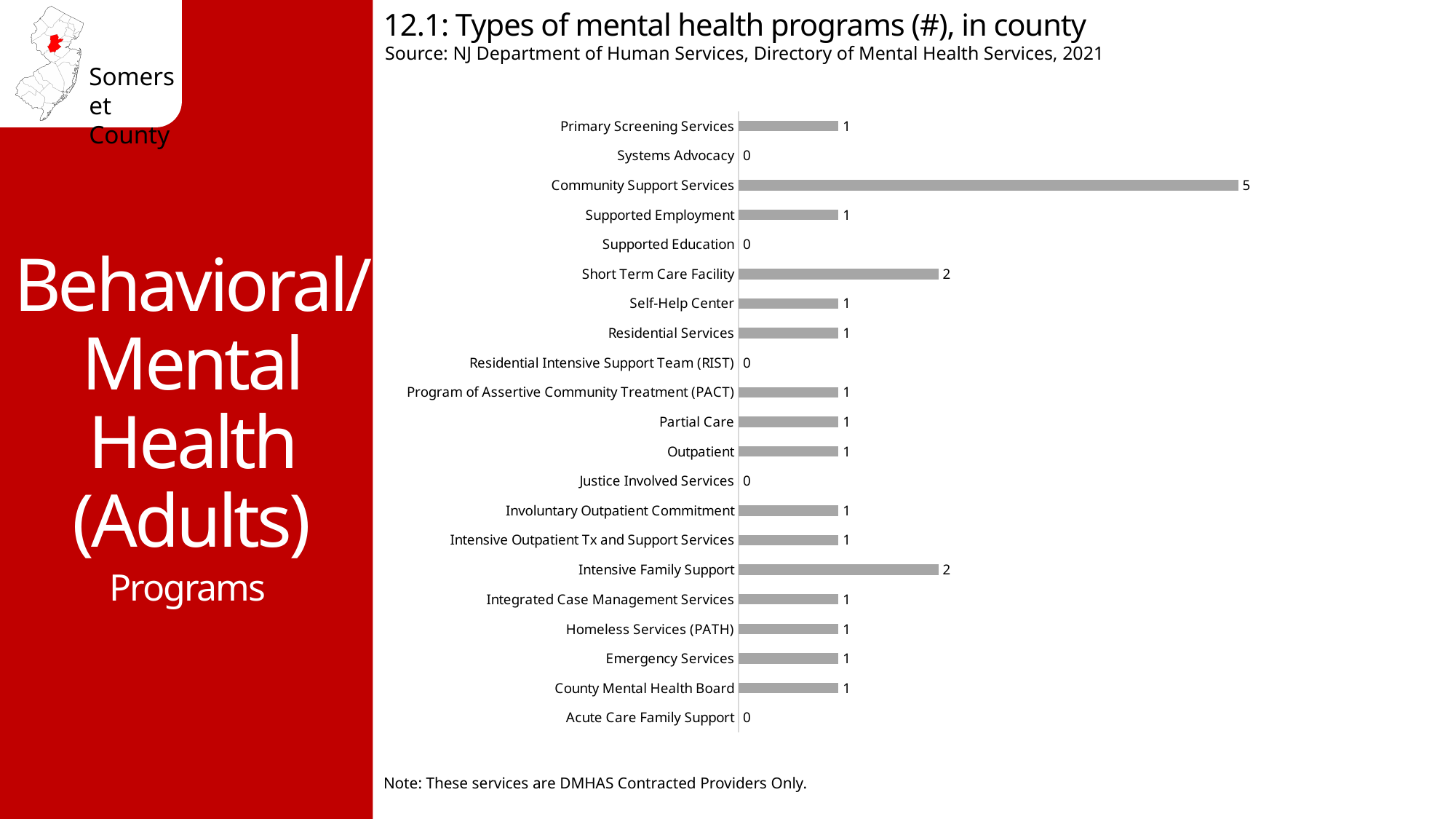
What is the value for Community Support Services? 5 What kind of chart is shown on the slide? Bar chart Which is larger, the value for Community Support Services or the value for Intensive Family Support? Community Support Services What is the value for Intensive Family Support? 2 Which category has the highest value? Community Support Services What is the title of the chart? 12.1: Types of mental health programs (#), in county Which is larger, the value for Intensive Family Support or the value for Outpatient? Intensive Family Support What is the value for Short Term Care Facility? 2 What is the value for Systems Advocacy? 0 What is the difference between the values for Community Support Services and Short Term Care Facility? 3 How many categories are shown in the chart? 21 What is the value for Homeless Services (PATH)? 1